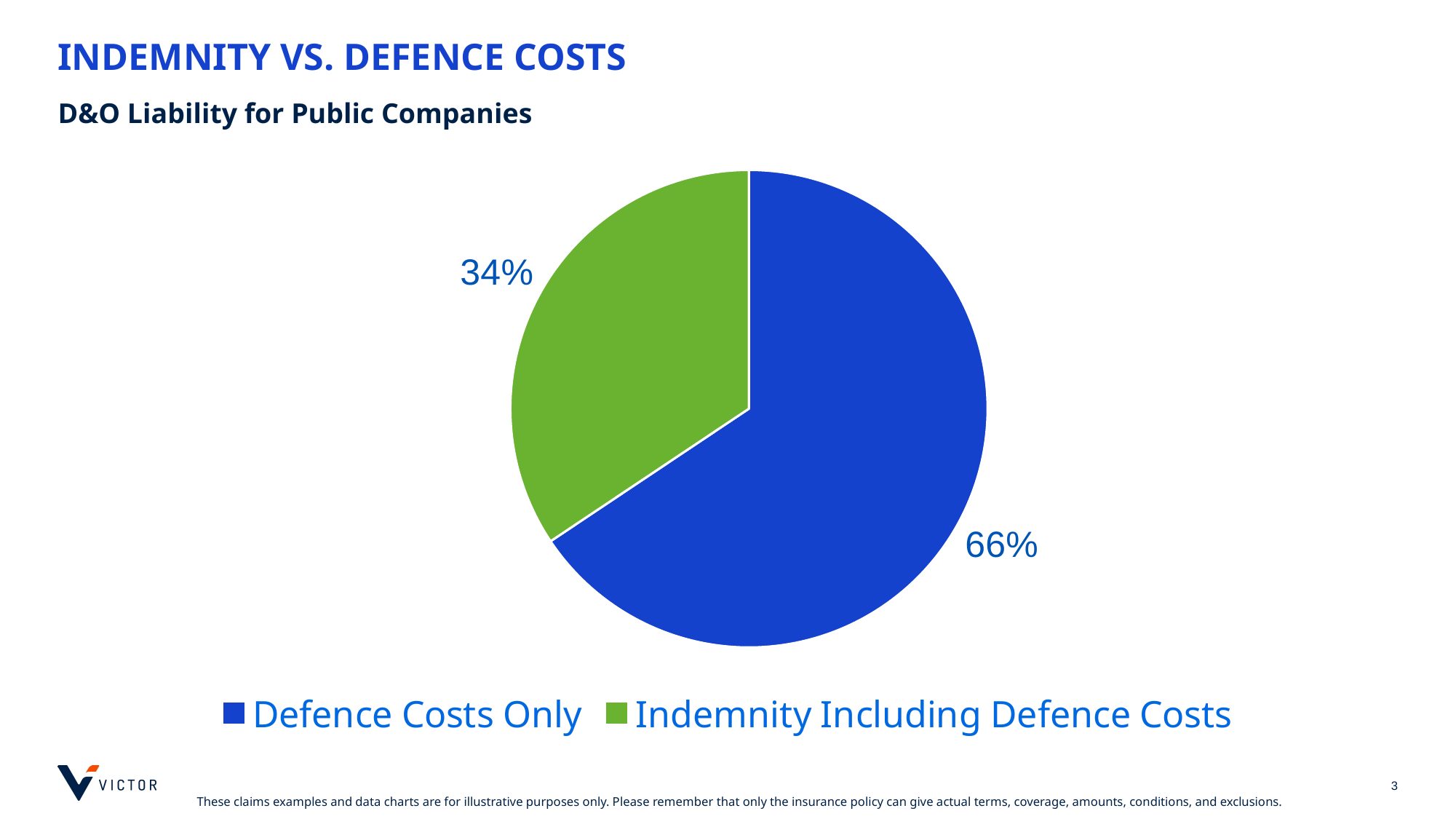
Which is larger: Defence Costs Only or Indemnity Including Defence Costs? Defence Costs Only What share of the pie does Indemnity Including Defence Costs represent? 34% Which slice of the pie is the smallest? Indemnity Including Defence Costs Which slice of the pie is the largest? Defence Costs Only How many entries does the legend list? 2 How many slices does the pie chart have? 2 What kind of chart is shown on the slide? Pie chart What percentage of the pie is Defence Costs Only? 66% What is the difference in percentage points between Defence Costs Only and Indemnity Including Defence Costs? 32 What colour is the Defence Costs Only slice? Blue What percentage of the pie is Indemnity Including Defence Costs? 34% What colour is the Indemnity Including Defence Costs slice? Green